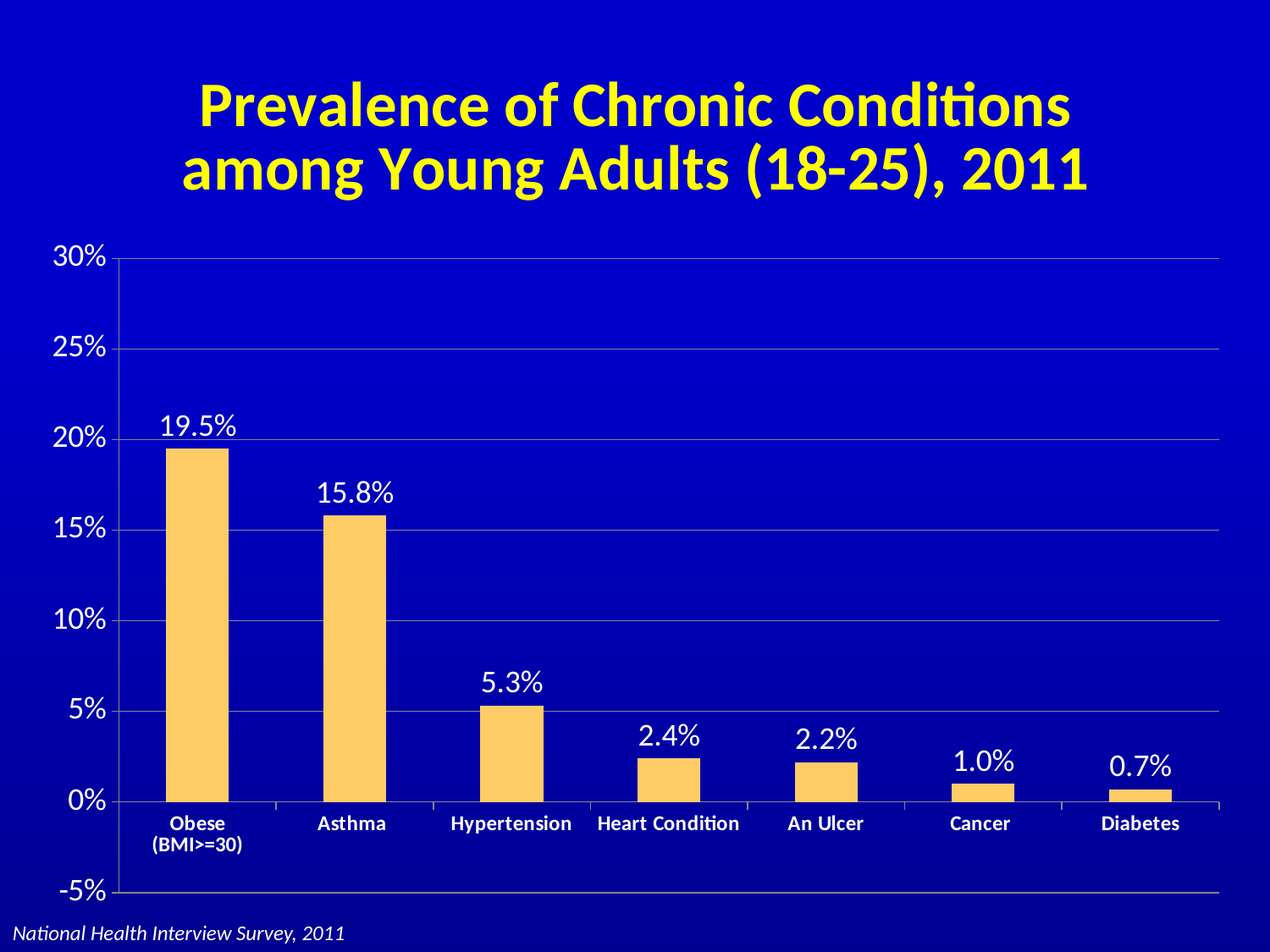
How many conditions are shown on the chart? 7 Which condition has the lowest prevalence on the chart? Diabetes Is the value for Obese (BMI>=30) greater or less than 20%? less Which is larger, the value for Hypertension or the value for Heart Condition? Hypertension What is the value shown for Diabetes? 0.7% What is the title of the chart? Prevalence of Chronic Conditions among Young Adults (18-25), 2011 What kind of chart is shown on the slide? Bar chart What is the prevalence of asthma among young adults shown on the chart? 15.8% What is the difference between the values for Heart Condition and An Ulcer? 0.2% Which condition has the highest prevalence on the chart? Obese (BMI>=30) What is the difference between the prevalence of Obese (BMI>=30) and Asthma? 3.7% What is the value shown for Hypertension? 5.3%